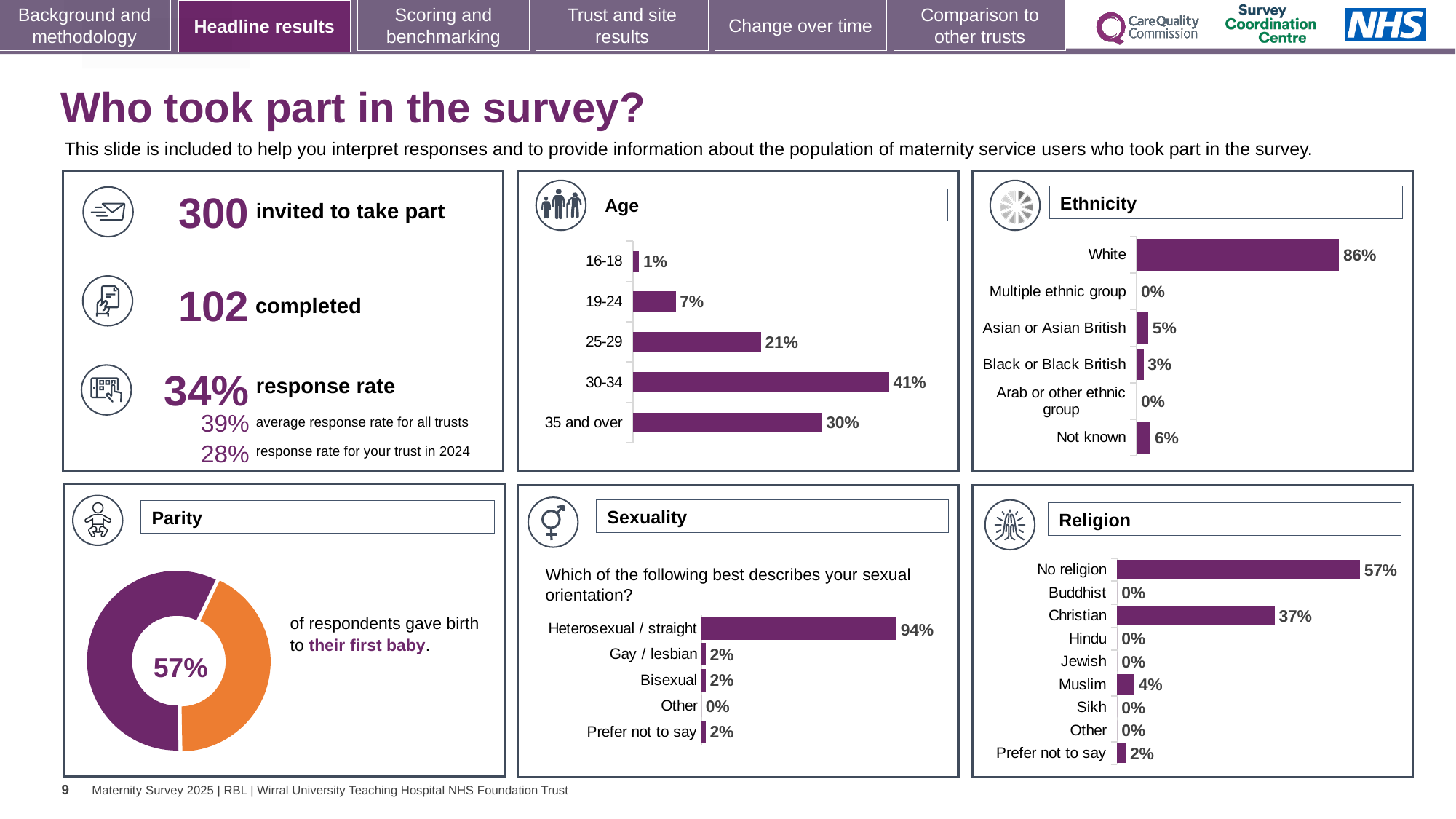
In the Parity chart, what percentage of respondents gave birth to their first baby? 57% How many categories does the Ethnicity chart show? 6 In the Ethnicity chart, what percentage of respondents were White? 86% How many categories does the Religion chart show? 9 In the Ethnicity chart, which is larger: Asian or Asian British or Black or Black British? Asian or Asian British In the Sexuality chart, what percentage of respondents answered Heterosexual / straight? 94% In the Religion chart, what percentage of respondents were Christian? 37% In the Age chart, which age group has the lowest percentage? 16-18 What kind of chart is the Parity chart? Doughnut chart In the Age chart, what is the difference between the 30-34 and 35 and over percentages? 11% In the Age chart, what percentage of respondents were aged 30-34? 41% In the Religion chart, which category has the highest percentage? No religion